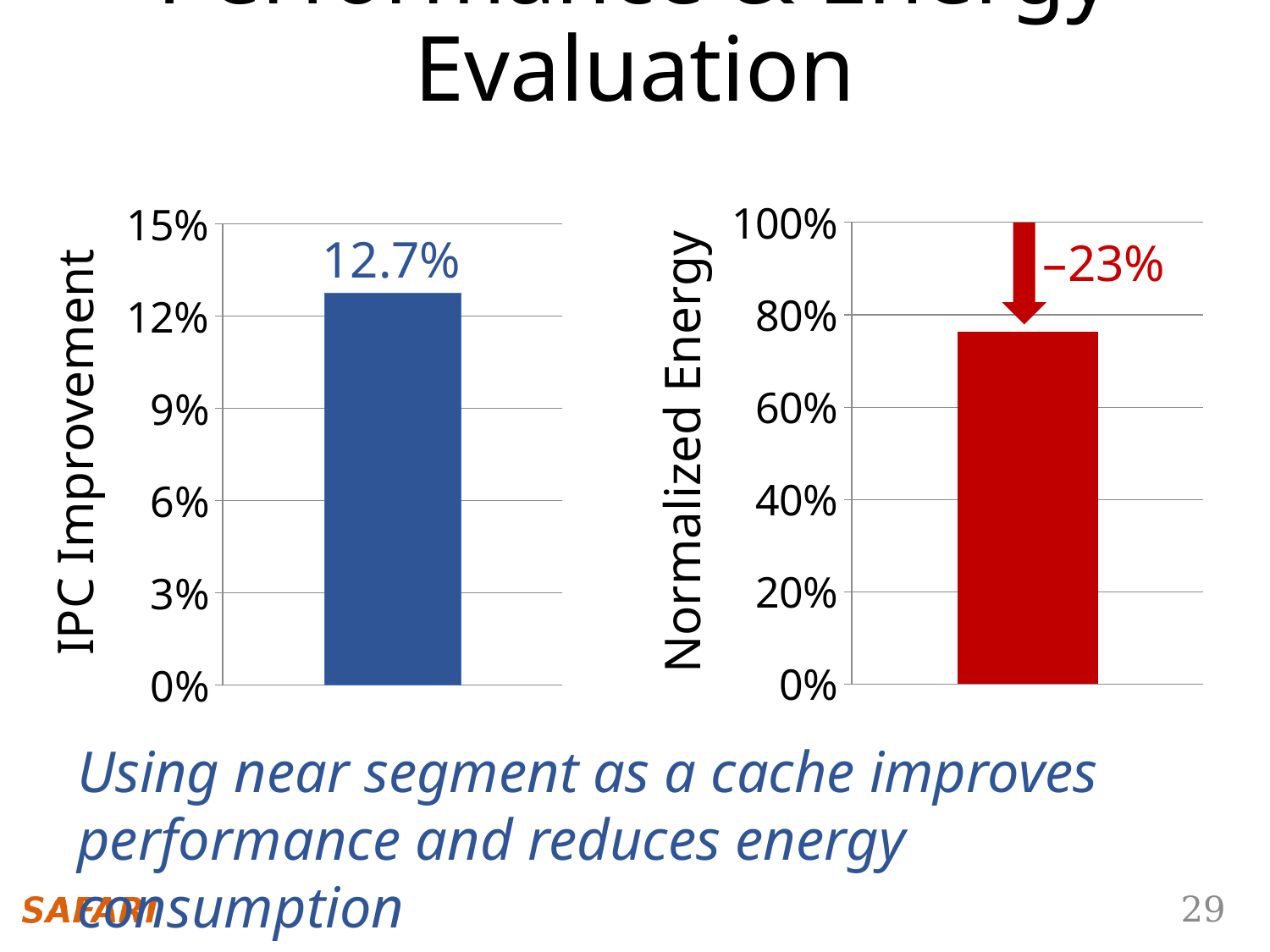
In the right chart (Normalized Energy), is the bar's value greater or less than 80%? less In the right chart (Normalized Energy), is the bar's value greater or less than 60%? greater What is the y-axis title of the right chart? Normalized Energy In the left chart (IPC Improvement), is the bar's value greater or less than 12%? greater What kind of chart is the right chart (Normalized Energy)? bar chart In the left chart (IPC Improvement), what value is printed on the bar? 12.7% What is the y-axis title of the left chart? IPC Improvement How many bars are plotted in the right chart (Normalized Energy)? 1 What kind of chart is the left chart (IPC Improvement)? bar chart How many bars are plotted in the left chart (IPC Improvement)? 1 In the right chart (Normalized Energy), what percentage change is annotated next to the arrow? –23%